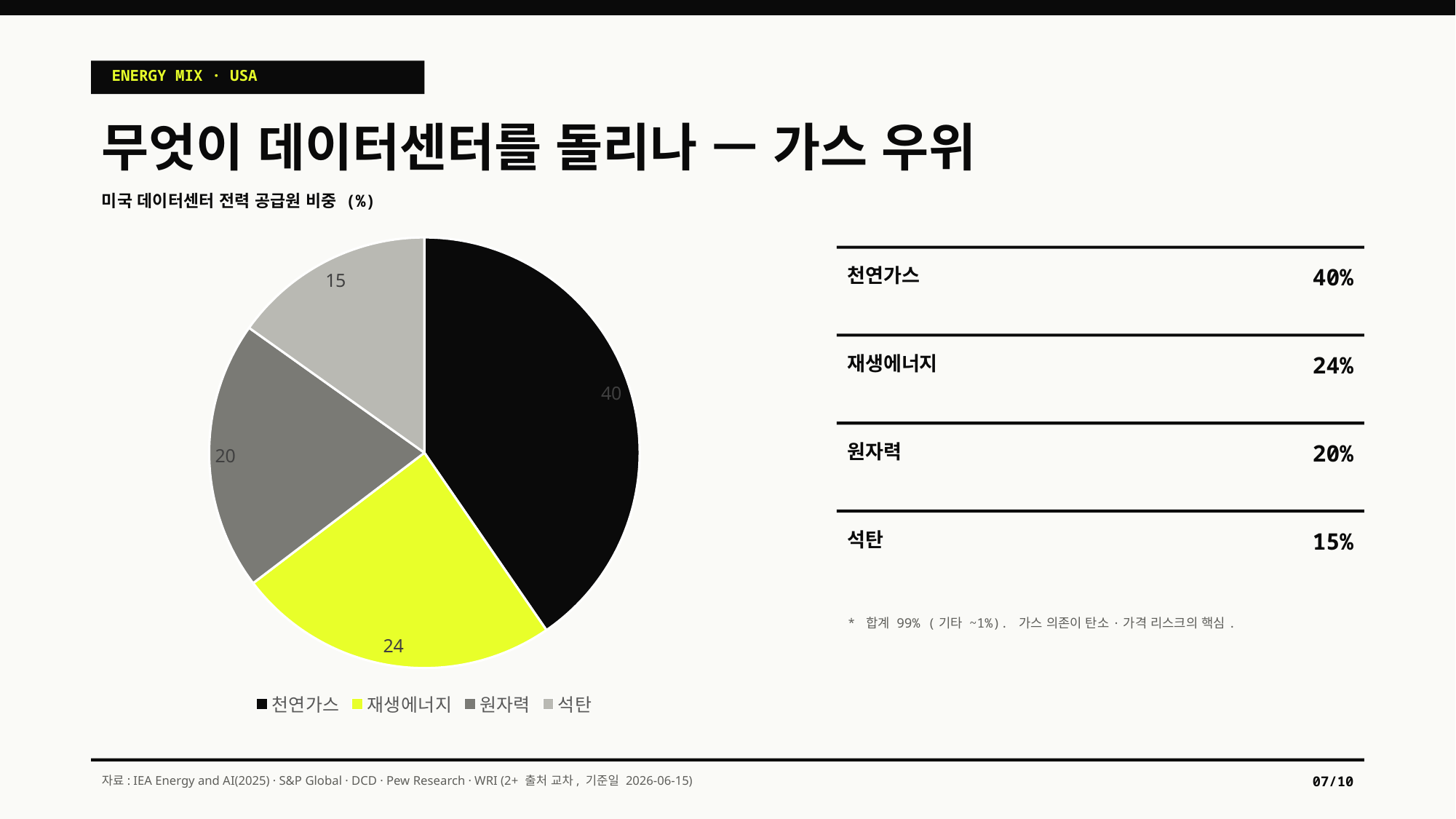
How many slices does the pie chart have? 4 What is the difference between the values for 천연가스 and 재생에너지? 16 What is the value for 석탄 in the pie chart? 15 How many entries does the legend list? 4 What colour is the 재생에너지 slice in the pie chart? yellow Which is larger, the value for 원자력 or the value for 석탄? 원자력 Which category has the largest slice in the pie chart? 천연가스 What is the value for 천연가스 in the pie chart? 40 What is the value for 원자력 in the pie chart? 20 Which category has the smallest slice in the pie chart? 석탄 What type of chart is shown on the slide? pie chart What is the value for 재생에너지 in the pie chart? 24